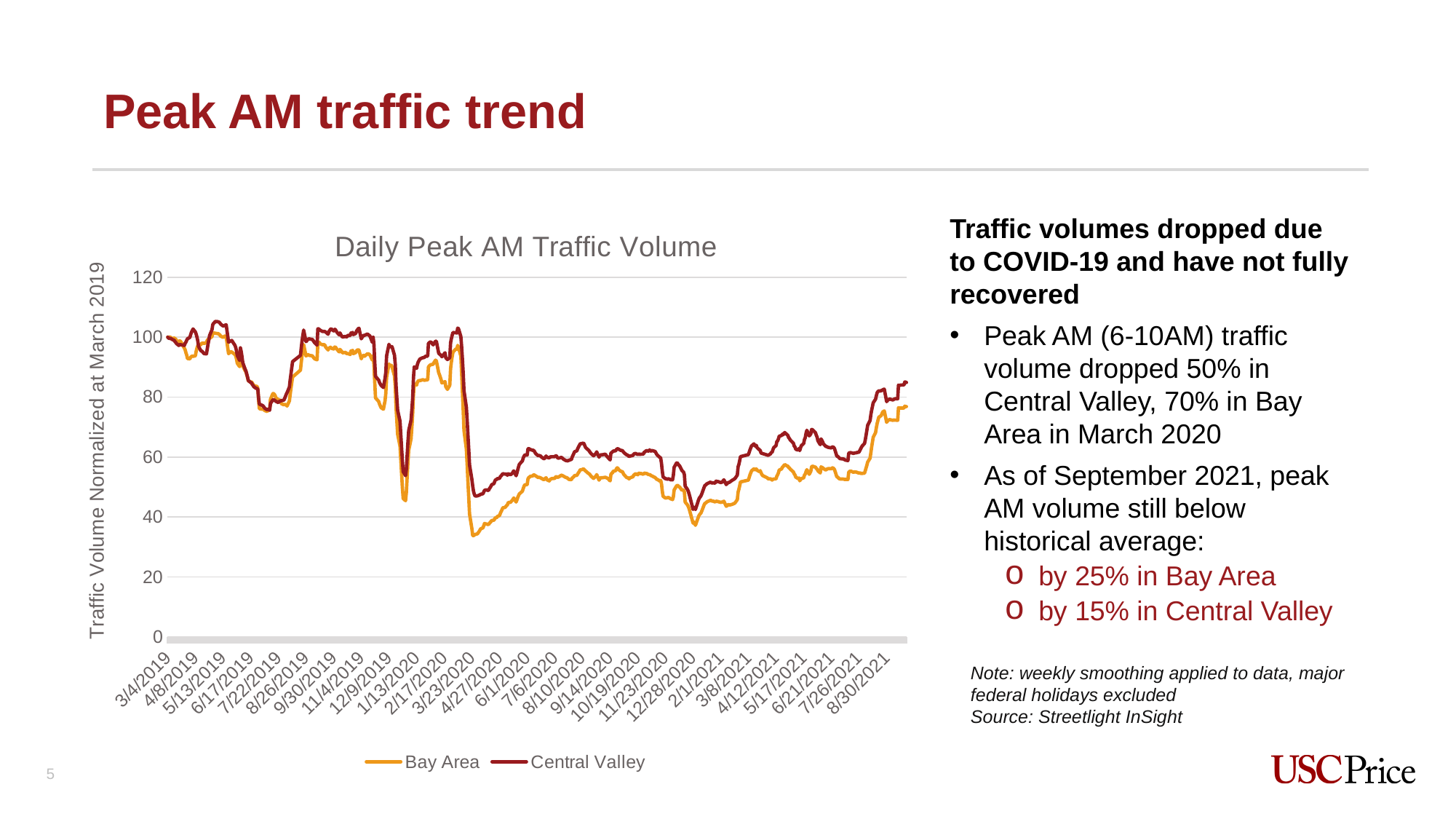
Do the values for both series rise or fall between 7/26/2021 and 8/30/2021? rise At 8/30/2021, which series has the higher value, Bay Area or Central Valley? Central Valley Is the Bay Area value around 7/6/2020 greater or less than 60? less What is the title of the chart? Daily Peak AM Traffic Volume What kind of chart is shown on the slide? line chart Is the Bay Area value at 8/30/2021 greater or less than 80? less How many series does the legend of the chart list? 2 Around 4/27/2020, which series has the lower value, Bay Area or Central Valley? Bay Area Do the values for both series rise or fall between 3/23/2020 and 4/27/2020? rise Which series is drawn in orange in the chart? Bay Area